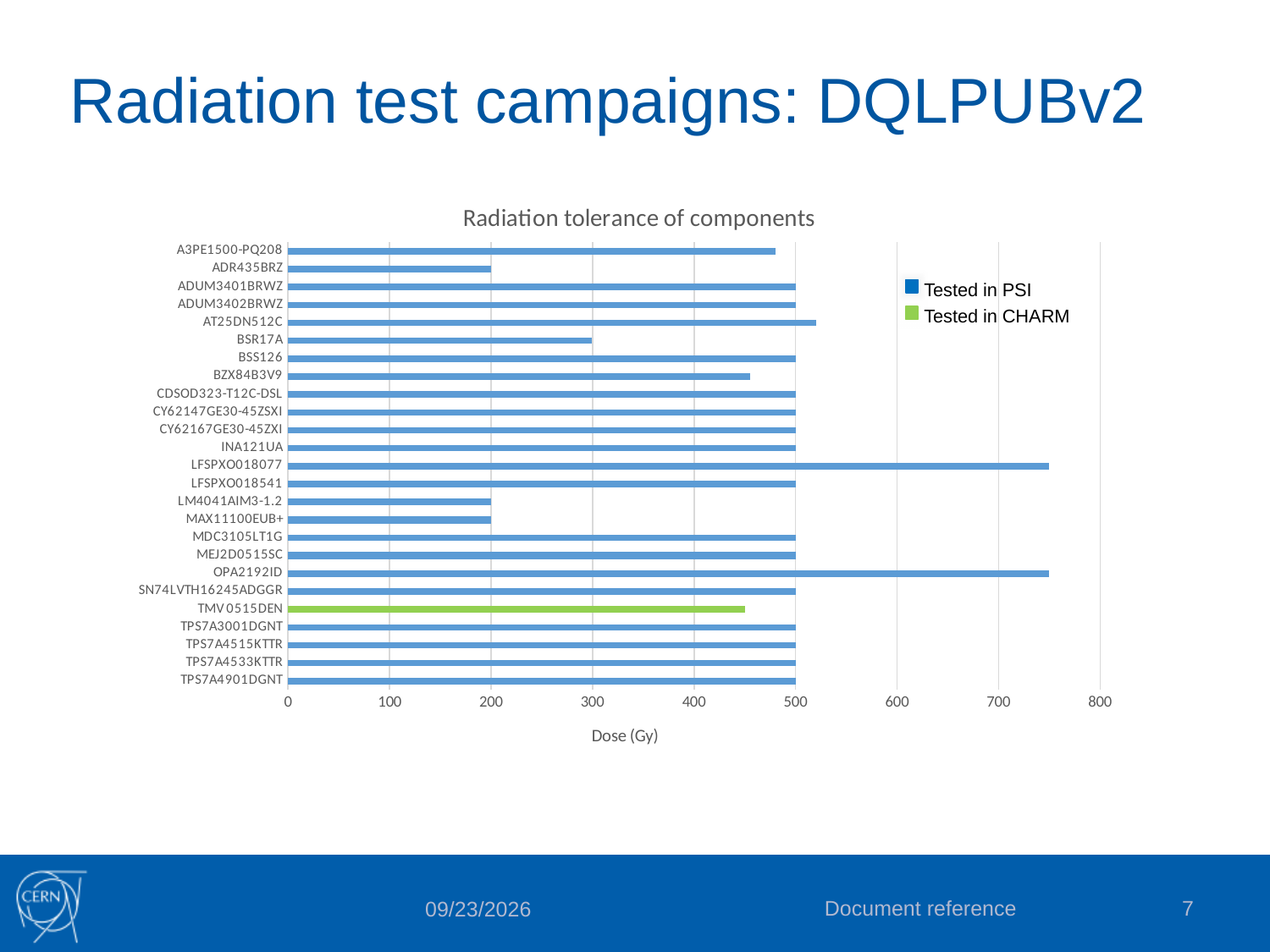
What is the dose value for BSS126? 500 How many series does the legend list? 2 Is the value for AT25DN512C greater or less than 500? greater Is the value for LFSPXO018077 greater or less than 700? greater What is the title of the chart? Radiation tolerance of components How many components are listed on the chart? 25 Is the value for TMV0515DEN greater or less than 500? less What is the dose value for ADR435BRZ? 200 What kind of chart is shown on the slide? bar chart Which has a larger value, BSR17A or MAX11100EUB+? BSR17A